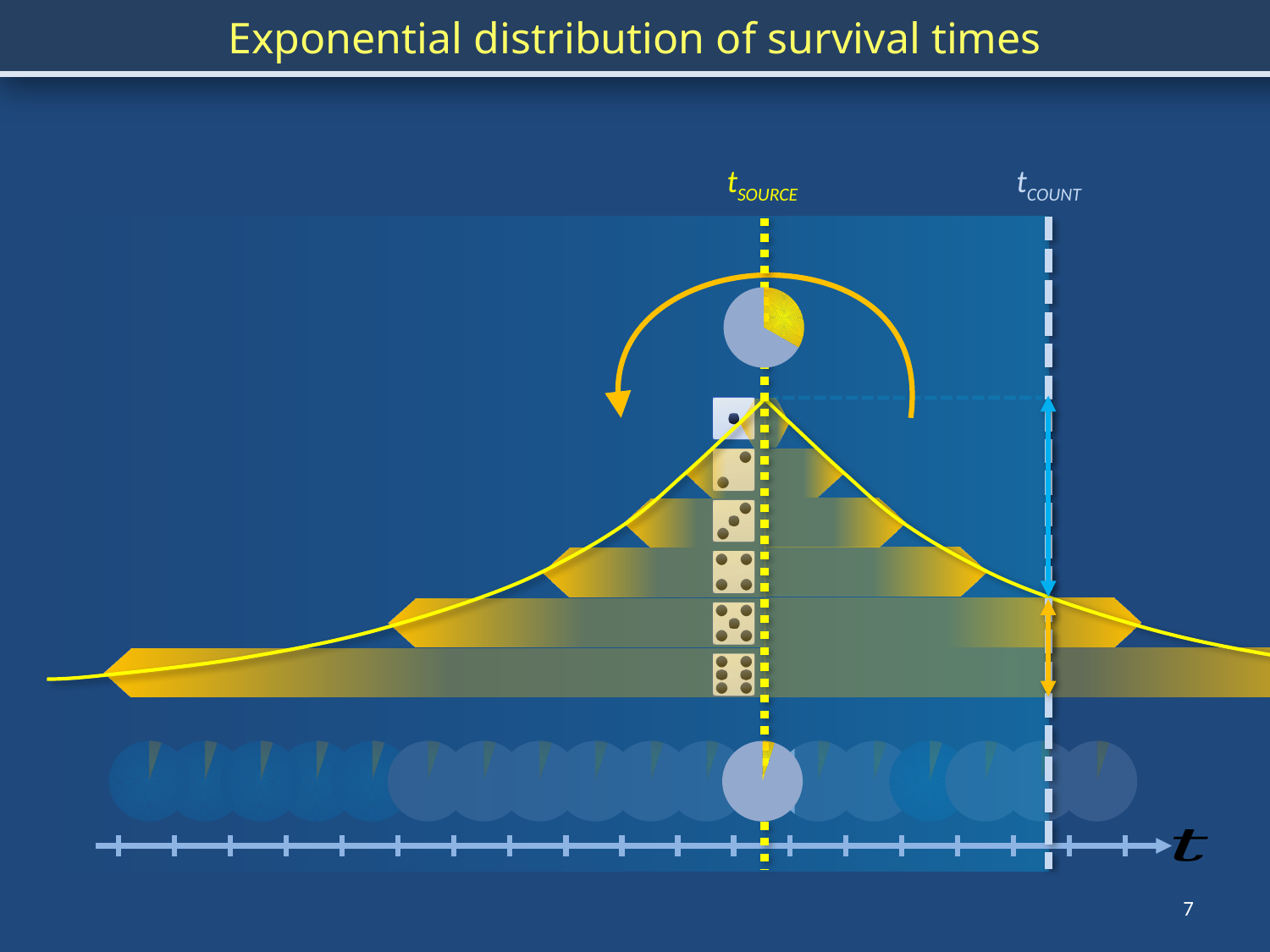
Moving along the t axis from t_SOURCE toward t_COUNT, does the yellow curve rise or fall? fall What is the title of the slide's chart? Exponential distribution of survival times What label is shown on the horizontal axis of the chart? t